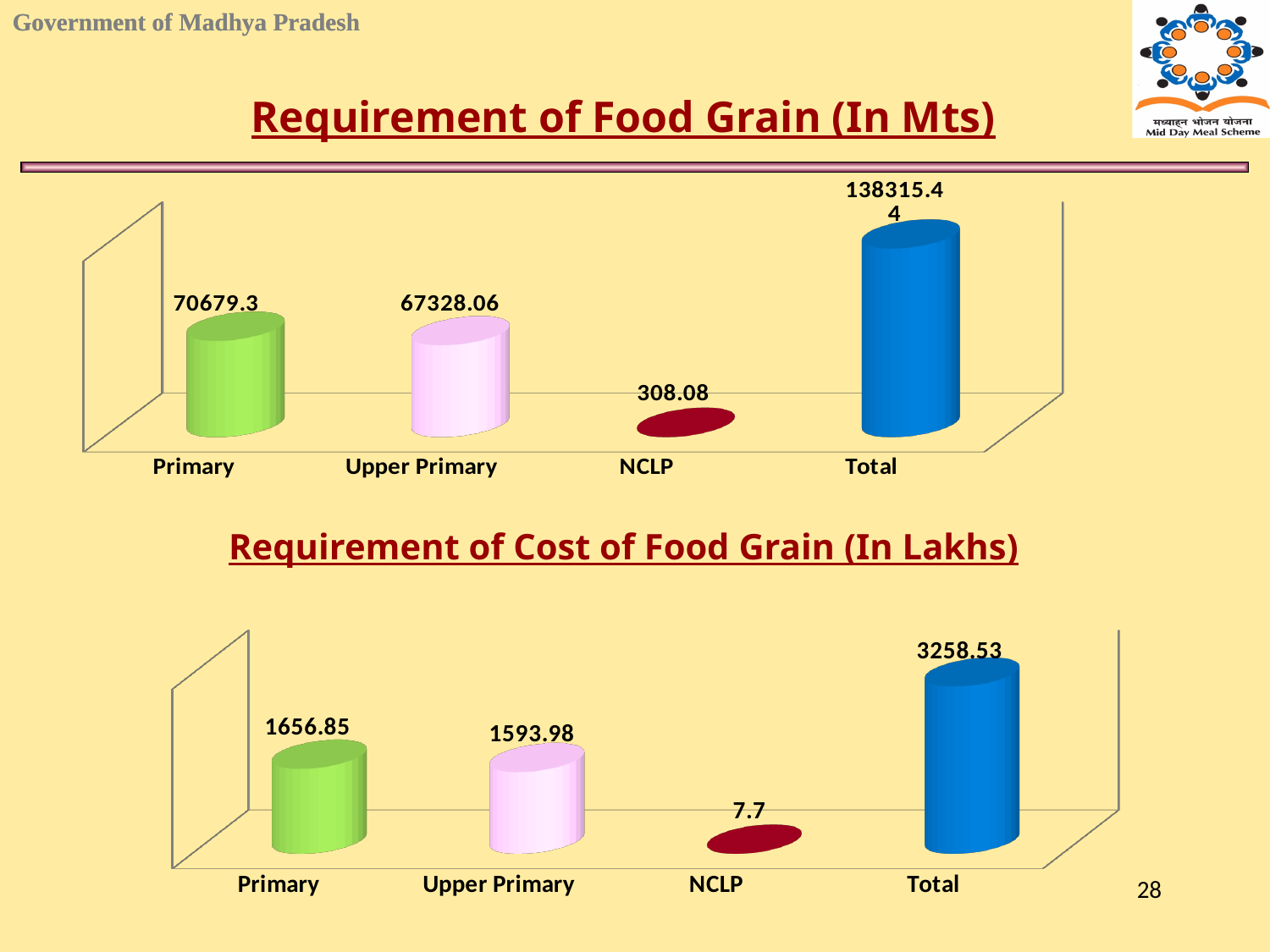
In the 'Requirement of Cost of Food Grain (In Lakhs)' chart, which is larger, Primary or Upper Primary? Primary In the 'Requirement of Food Grain (In Mts)' chart, which category has the lowest value? NCLP In the 'Requirement of Cost of Food Grain (In Lakhs)' chart, what is the value for NCLP? 7.7 In the 'Requirement of Food Grain (In Mts)' chart, what is the value for Upper Primary? 67328.06 In the 'Requirement of Food Grain (In Mts)' chart, what is the difference between the Primary and Upper Primary values? 3351.24 In the 'Requirement of Cost of Food Grain (In Lakhs)' chart, what is the difference between the Primary and Upper Primary values? 62.87 How many categories are shown in the 'Requirement of Cost of Food Grain (In Lakhs)' chart? 4 In the 'Requirement of Cost of Food Grain (In Lakhs)' chart, what is the value for Total? 3258.53 In the 'Requirement of Cost of Food Grain (In Lakhs)' chart, what is the value for Primary? 1656.85 In the 'Requirement of Food Grain (In Mts)' chart, which category has the highest value? Total In the 'Requirement of Food Grain (In Mts)' chart, what is the value for Primary? 70679.3 In the 'Requirement of Food Grain (In Mts)' chart, what is the value for NCLP? 308.08